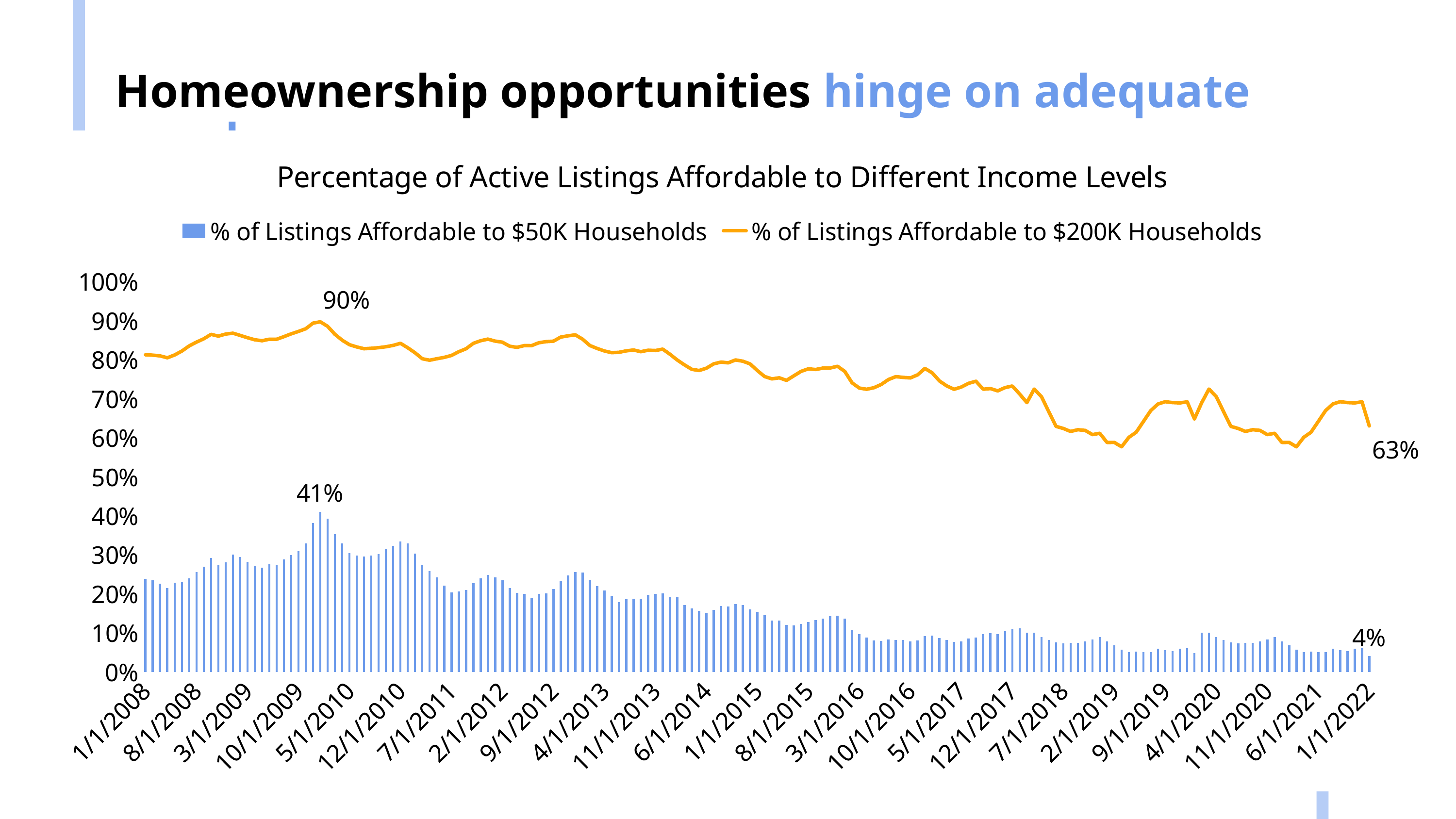
What is the difference between the peak value (41%) and the 1/1/2022 value (4%) for % of Listings Affordable to $50K Households? 37 percentage points What is the value for % of Listings Affordable to $200K Households at 1/1/2022? 63% What is the difference between the peak value (90%) and the 1/1/2022 value (63%) for % of Listings Affordable to $200K Households? 27 percentage points What is the highest labelled value for % of Listings Affordable to $200K Households? 90% What is the value for % of Listings Affordable to $50K Households at 1/1/2022? 4% What is the title of the chart? Percentage of Active Listings Affordable to Different Income Levels What is the highest labelled value for % of Listings Affordable to $50K Households? 41% How many series does the chart legend list? 2 Is the value for % of Listings Affordable to $50K Households at 1/1/2008 greater or less than 20%? greater Overall, do the values for % of Listings Affordable to $50K Households rise or fall from 1/1/2008 to 1/1/2022? Fall What kind of chart is shown on the slide? Combined bar and line chart At 1/1/2022, which series has the larger value: % of Listings Affordable to $50K Households or % of Listings Affordable to $200K Households? % of Listings Affordable to $200K Households